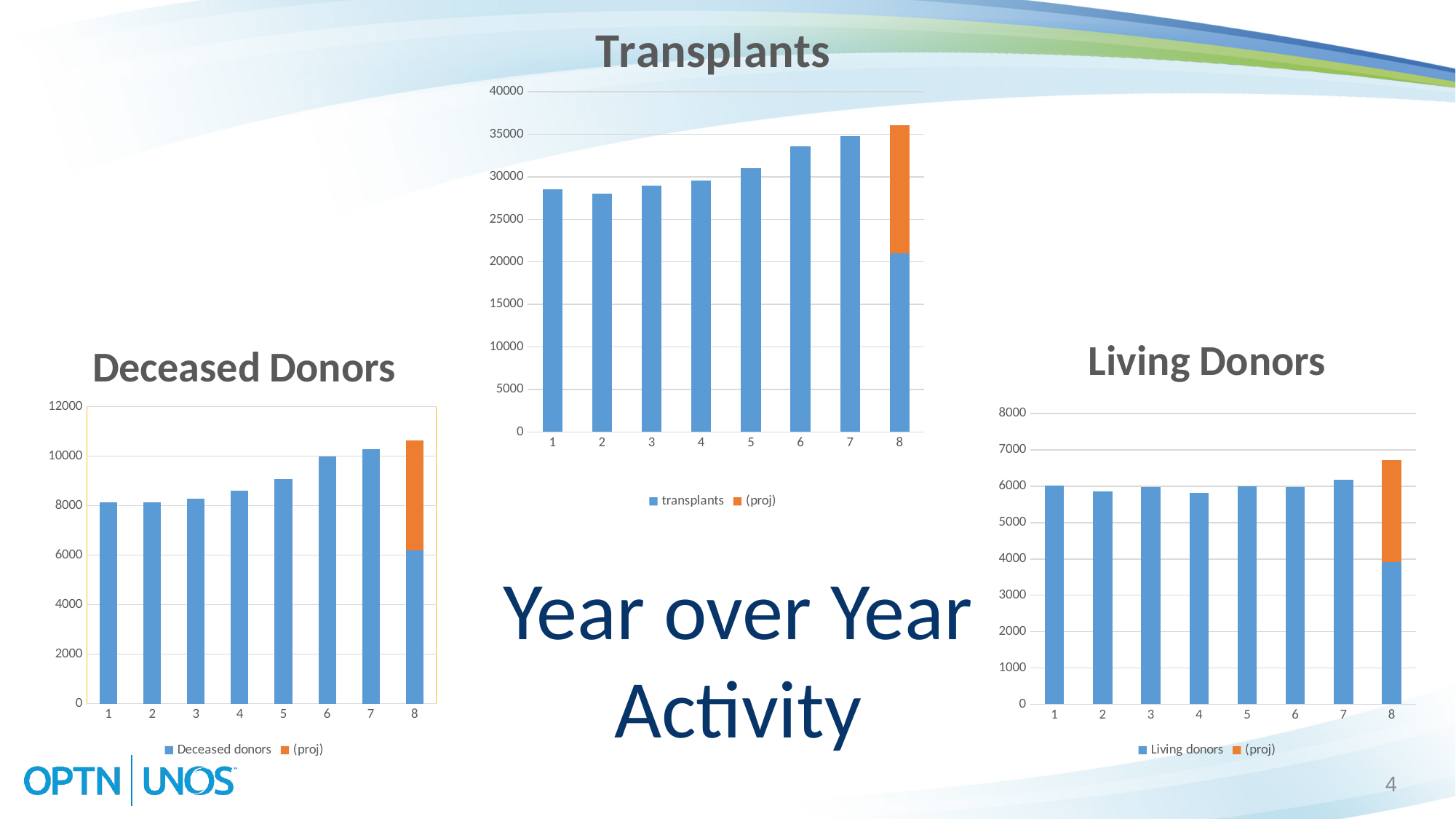
On the Transplants chart, which is larger, the value for category 1 or category 6? 6 On the Living Donors chart, what are the two legend entries? Living donors, (proj) On the Deceased Donors chart, which is larger, the value for category 2 or category 7? 7 On the Deceased Donors chart, which category includes an orange (proj) segment? 8 On the Transplants chart, is the value for category 2 greater or less than 30000? less On the Transplants chart, what kind of chart is shown? bar chart On the Deceased Donors chart, is the value for category 6 greater or less than 8000? greater On the Transplants chart, how many series does the legend list? 2 On the Transplants chart, how many categories are shown on the x axis? 8 On the Deceased Donors chart, do the values rise or fall from category 1 to category 7? rise On the Living Donors chart, is the value for category 7 greater or less than 5000? greater